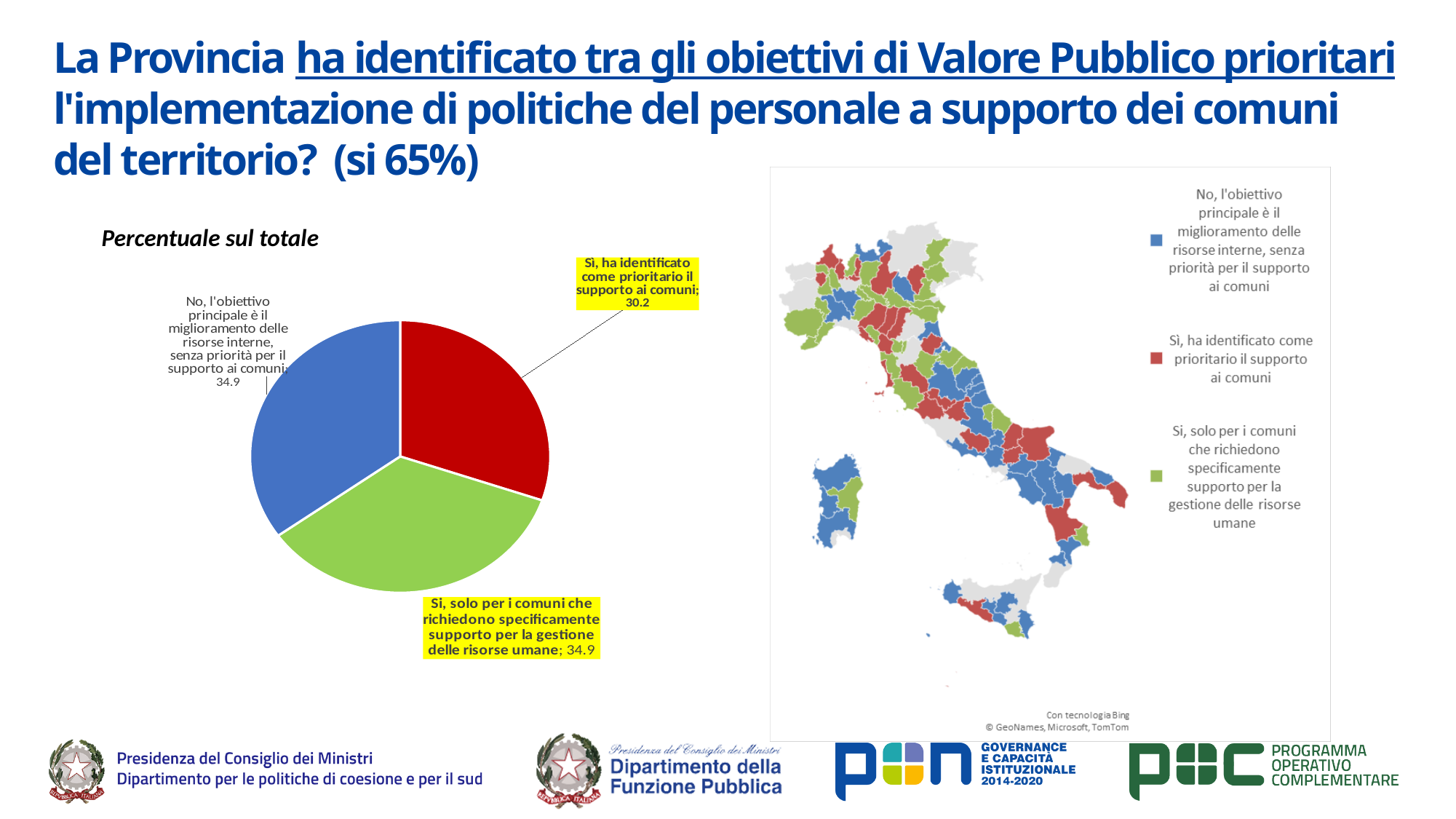
What kind of chart is the chart titled 'Percentuale sul totale' on the left of the slide? Pie chart In the pie chart titled 'Percentuale sul totale', what is the difference between the value for 'No, l'obiettivo principale è il miglioramento delle risorse interne' and the value for 'Sì, ha identificato come prioritario il supporto ai comuni'? 4.7 In the pie chart titled 'Percentuale sul totale', what is the value for 'Sì, ha identificato come prioritario il supporto ai comuni'? 30.2 How many slices does the pie chart titled 'Percentuale sul totale' have? 3 In the pie chart titled 'Percentuale sul totale', is the value for 'Sì, ha identificato come prioritario il supporto ai comuni' greater or less than the value for 'No, l'obiettivo principale è il miglioramento delle risorse interne'? less In the pie chart titled 'Percentuale sul totale', what is the value for 'No, l'obiettivo principale è il miglioramento delle risorse interne, senza priorità per il supporto ai comuni'? 34.9 What is the title of the pie chart on the left of the slide? Percentuale sul totale In the pie chart titled 'Percentuale sul totale', which category has the smallest slice? Sì, ha identificato come prioritario il supporto ai comuni In the pie chart titled 'Percentuale sul totale', what colour is the slice for 'Sì, ha identificato come prioritario il supporto ai comuni'? Red In the pie chart titled 'Percentuale sul totale', which is larger: the slice for 'Si, solo per i comuni che richiedono specificamente supporto' or the slice for 'Sì, ha identificato come prioritario il supporto ai comuni'? Si, solo per i comuni che richiedono specificamente supporto In the pie chart titled 'Percentuale sul totale', what is the value for 'Si, solo per i comuni che richiedono specificamente supporto per la gestione delle risorse umane'? 34.9